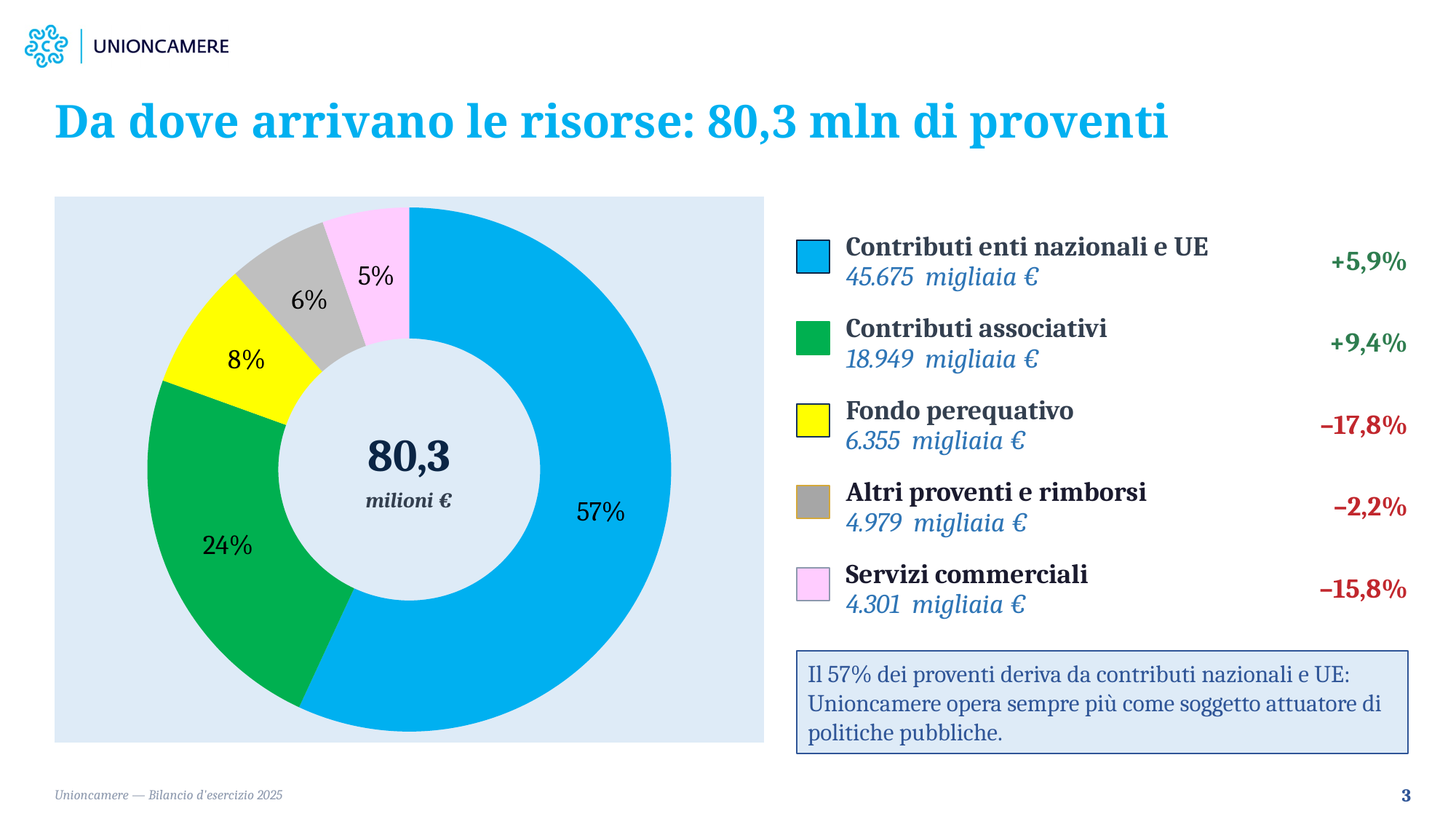
Which category has the smallest slice of the pie? Servizi commerciali What is the difference in percentage points between the Contributi enti nazionali e UE slice and the Contributi associativi slice? 33 percentage points What share of the pie does Contributi associativi represent? 24% What share of the pie does Fondo perequativo represent? 8% What total value is shown in the centre of the donut chart? 80,3 milioni € What share of the pie does Contributi enti nazionali e UE represent? 57% Which slice is larger: Fondo perequativo or Altri proventi e rimborsi? Fondo perequativo How many categories does the pie chart show? 5 Which category has the largest slice of the pie? Contributi enti nazionali e UE What is the value in migliaia € for Contributi associativi? 18.949 migliaia € What kind of chart is shown on the slide? Pie chart (donut)